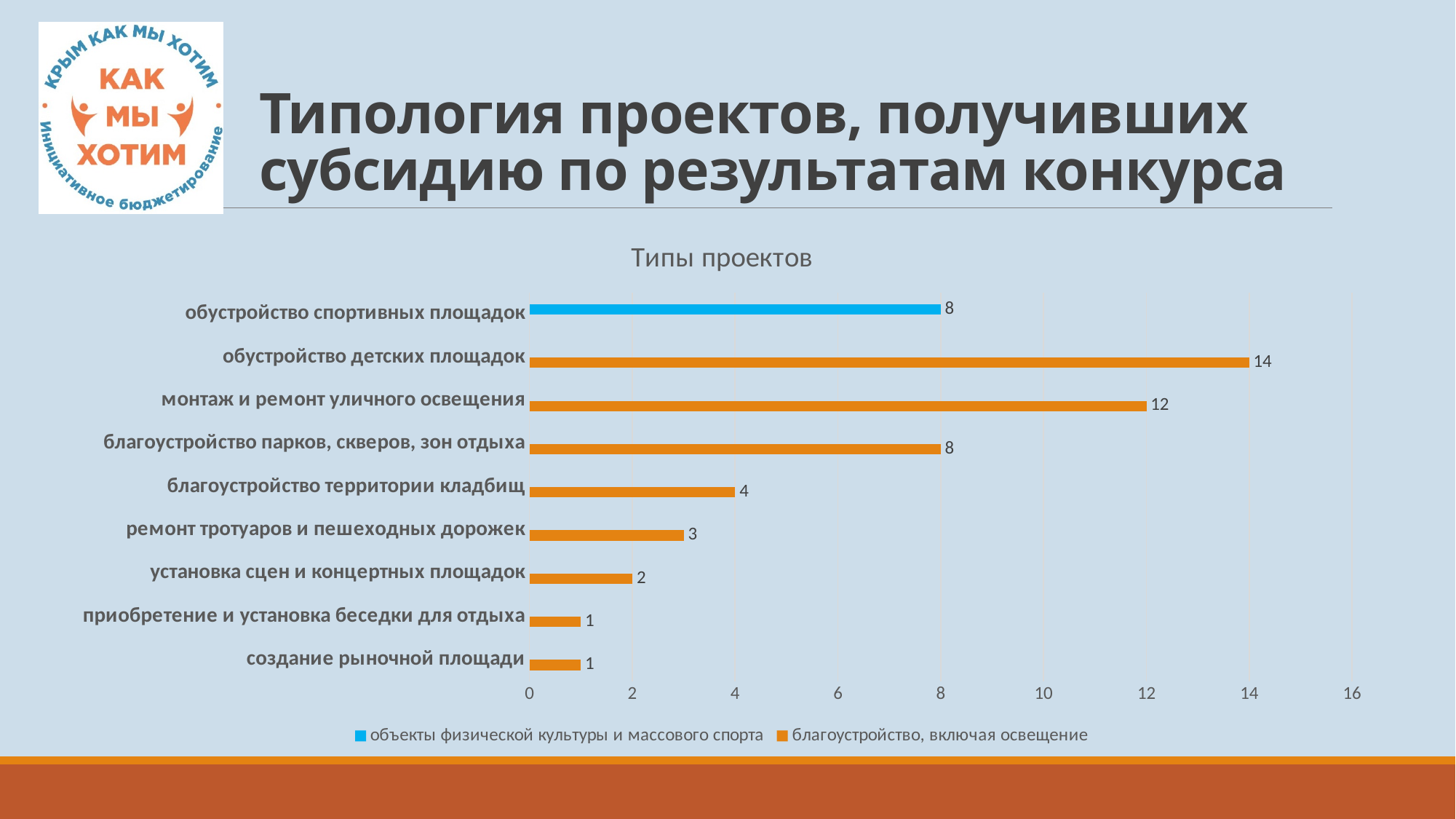
How many series does the legend list? 2 Which category has the highest value? обустройство детских площадок How many categories are shown in the chart? 9 What is the title of the chart? Типы проектов What is the difference between обустройство детских площадок and монтаж и ремонт уличного освещения? 2 What is the value for обустройство детских площадок? 14 What is the value for обустройство спортивных площадок? 8 Which series is shown in blue? объекты физической культуры и массового спорта What is the value for благоустройство территории кладбищ? 4 Which is larger: ремонт тротуаров и пешеходных дорожек or установка сцен и концертных площадок? ремонт тротуаров и пешеходных дорожек What is the value for монтаж и ремонт уличного освещения? 12 What kind of chart is shown? bar chart